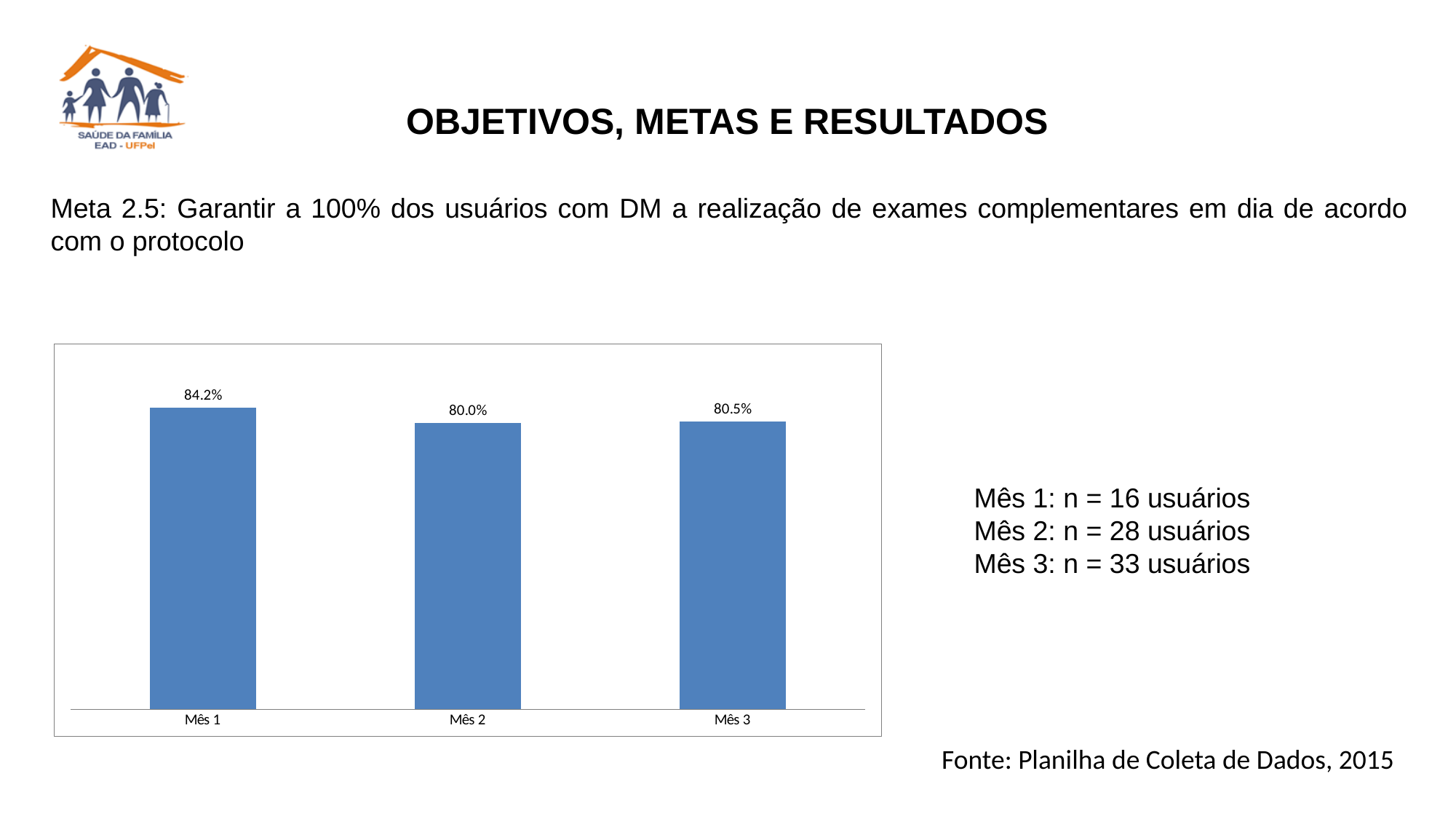
What is the value shown for Mês 3? 80.5% What is the difference between the values for Mês 1 and Mês 2? 4.2 percentage points What is the difference between the values for Mês 1 and Mês 3? 3.7 percentage points Does the value rise or fall from Mês 1 to Mês 2? Fall Which is larger, the value for Mês 1 or the value for Mês 3? Mês 1 How many categories (months) are plotted in the chart? 3 What is the value shown for Mês 2? 80.0% What is the difference between the values for Mês 3 and Mês 2? 0.5 percentage points What kind of chart is shown on the slide? Bar chart What is the value shown for Mês 1? 84.2% What colour are the bars in the chart? Blue Which month has the highest value in the chart? Mês 1